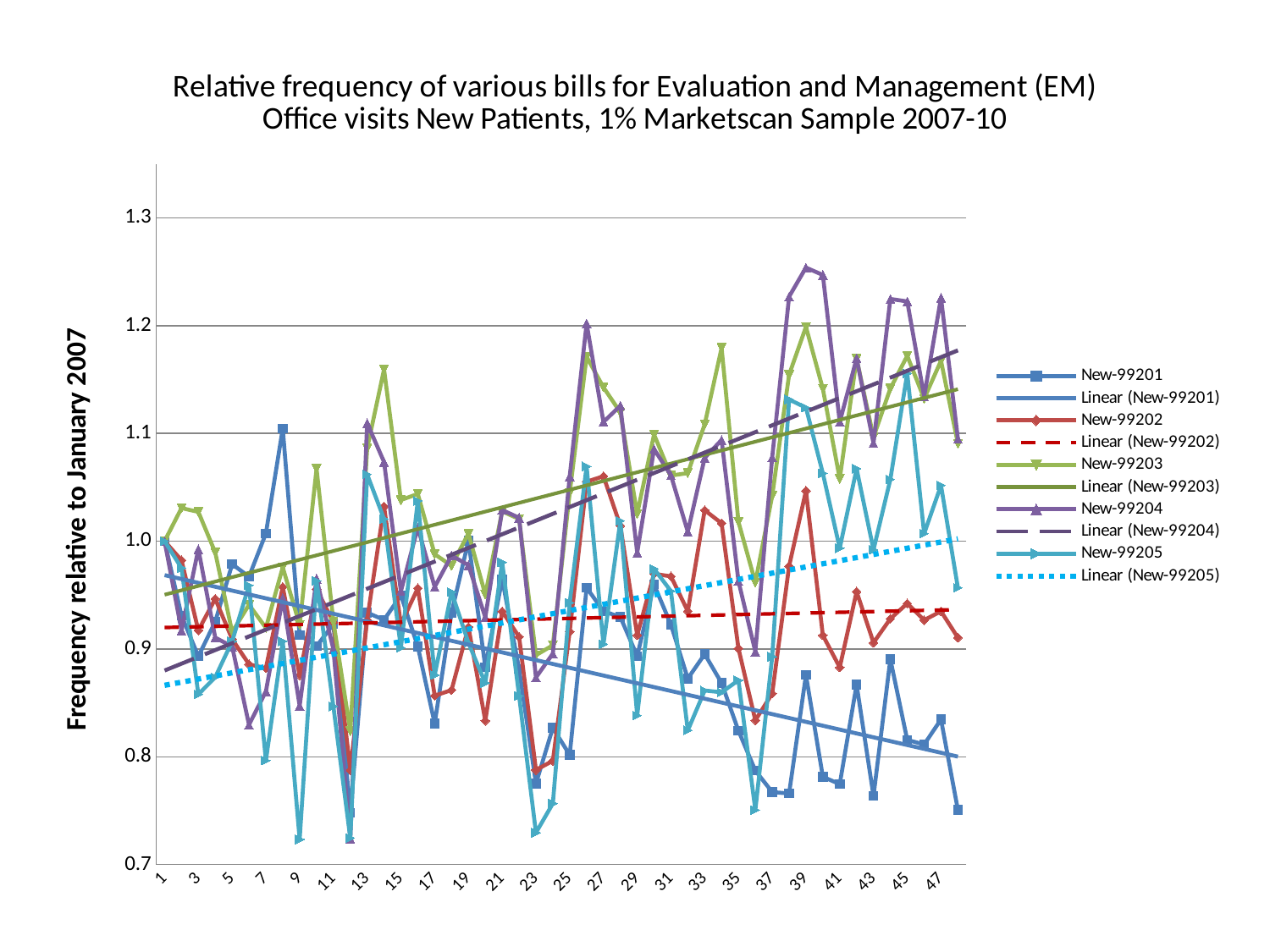
Which legend entry is drawn as a dotted line? Linear (New-99205) What is the label on the vertical axis of the chart? Frequency relative to January 2007 Is the value for New-99201 at point 48 greater or less than 0.8? less Does the linear trend line for New-99201 rise or fall along the x axis? fall At point 48, which series has the larger value, New-99204 or New-99201? New-99204 Is the value for New-99204 at point 39 greater or less than 1.2? greater Is the value for New-99205 at point 23 greater or less than 0.8? less Does the linear trend line for New-99204 rise or fall along the x axis? rise How many entries does the legend list? 10 Which series reaches the highest value anywhere on the chart? New-99204 What kind of chart is shown on the slide? line chart